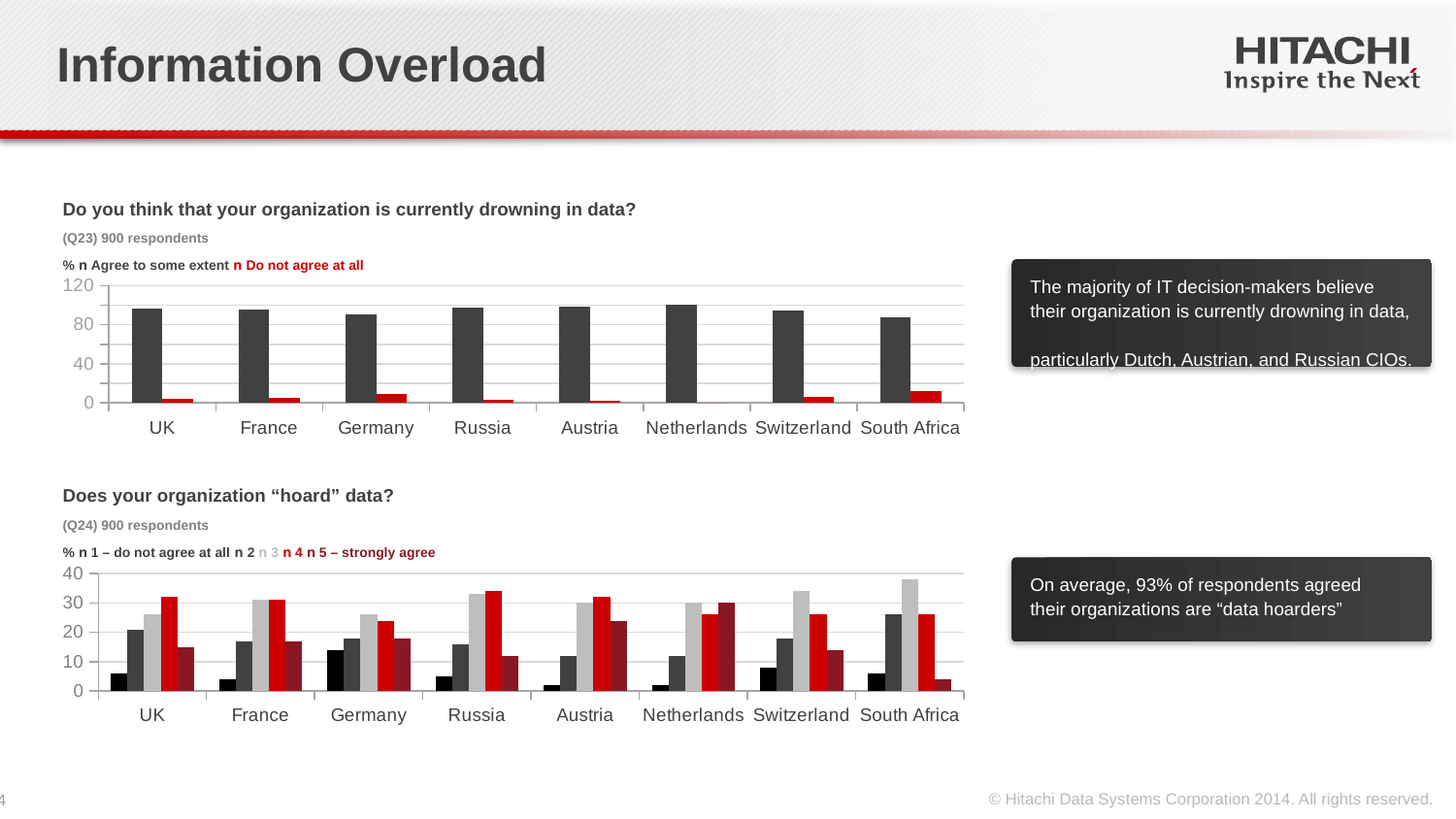
In the bottom chart ('Does your organization "hoard" data?'), how many series does the legend list? 5 In the top chart ('drowning in data'), how many countries are shown on the x axis? 8 In the bottom chart ('hoard data'), which country has the highest value for '1 – do not agree at all'? Germany In the top chart ('drowning in data'), is the 'Agree to some extent' value for the UK greater or less than 80? greater In the bottom chart ('hoard data'), is the value for series '4' for Russia greater or less than 30? greater In the bottom chart ('hoard data'), which country has the highest value for series '3'? South Africa In the top chart ('drowning in data'), what colour represents the 'Do not agree at all' series? Red In the top chart ('drowning in data'), which country has the highest 'Do not agree at all' value? South Africa In the bottom chart ('hoard data'), which country has the lowest value for '5 – strongly agree'? South Africa What kind of chart is the top chart, 'Do you think that your organization is currently drowning in data?' Bar chart In the top chart ('drowning in data'), is the 'Do not agree at all' value for South Africa greater or less than 40? less In the top chart ('drowning in data'), how many series does the legend list? 2